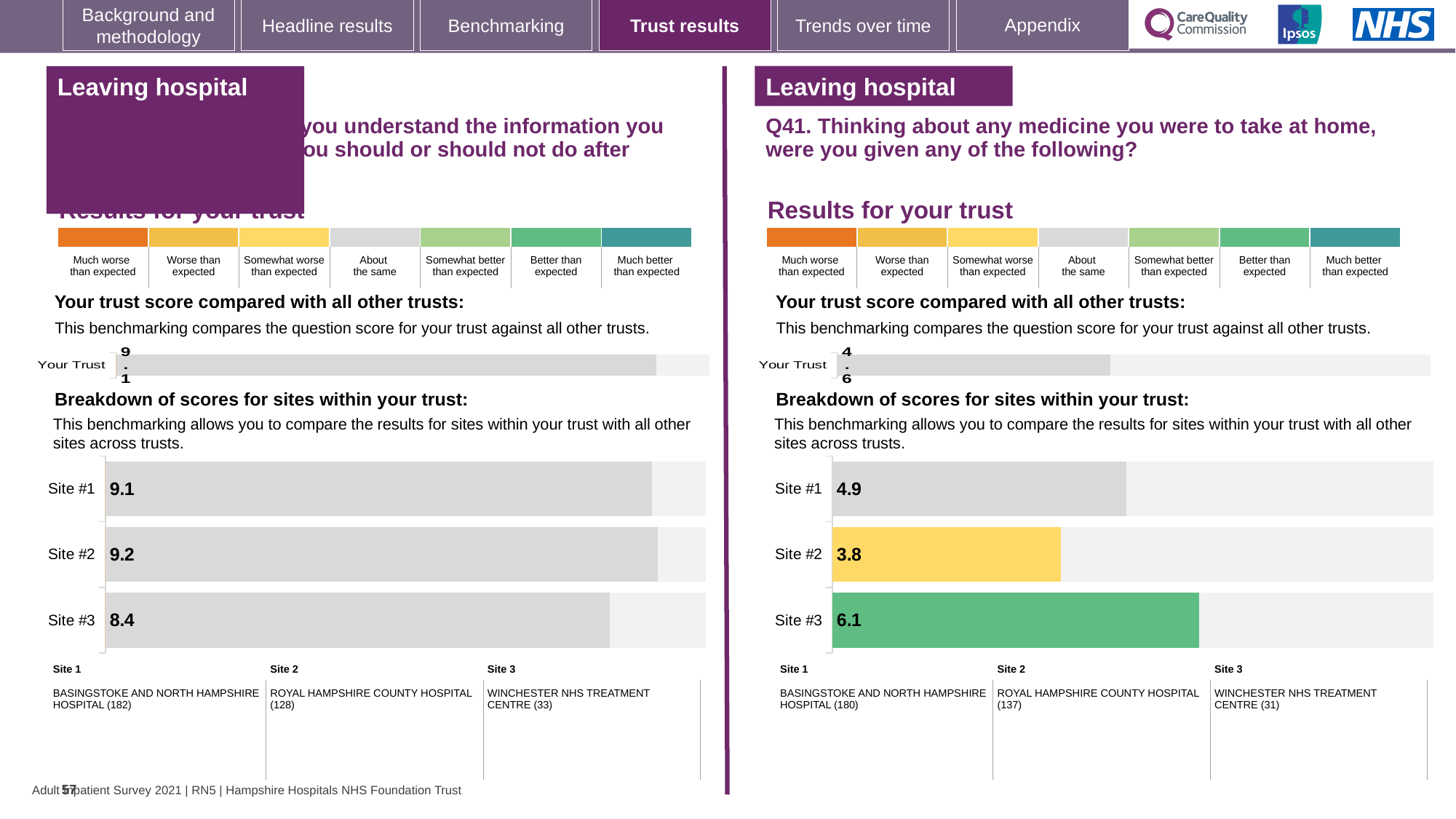
On the right-hand (Q41) site breakdown chart, which site has the lowest score? Site #2 How many sites are shown on the right-hand (Q41) site breakdown chart? 3 On the right-hand (Q41) site breakdown chart, which site has the highest score? Site #3 On the left-hand site breakdown chart, what is the difference between the scores for Site #2 and Site #3? 0.8 On the left-hand site breakdown chart, what is the score for Site #3? 8.4 What type of chart is used for the site breakdown on the right-hand (Q41) side of the slide? Bar chart On the right-hand (Q41) 'Your Trust' chart, what is the trust score? 4.6 On the right-hand (Q41) site breakdown chart, what is the score for Site #2? 3.8 On the right-hand (Q41) site breakdown chart, what is the difference between the scores for Site #3 and Site #2? 2.3 On the right-hand (Q41) site breakdown chart, what is the score for Site #1? 4.9 On the left-hand 'Your Trust' chart, what is the trust score? 9.1 On the left-hand site breakdown chart, which site has the lowest score? Site #3